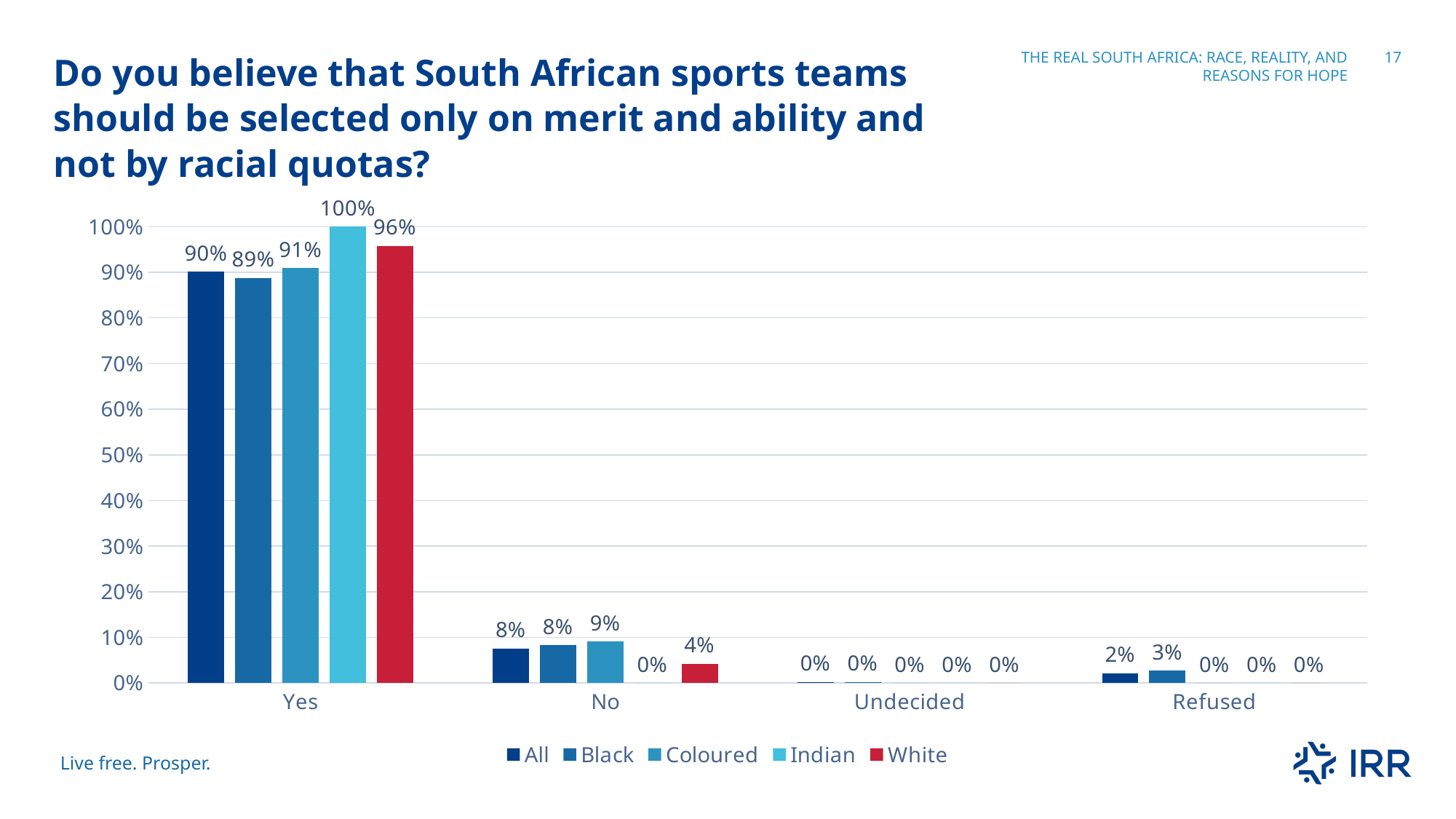
What is the difference between the White and All values for Yes? 6% What percentage of Indian respondents answered Yes? 100% Which group has the lowest value for Yes? Black Is the value for Black respondents answering Yes greater or less than 80%? greater How many response categories are shown on the x axis? 4 What kind of chart is shown on the slide? Bar chart Which group has the highest value for Yes? Indian Which series is shown in red? White Which is larger for No: the Coloured value or the White value? Coloured What percentage of Black respondents answered Refused? 3% What percentage of White respondents answered No? 4% How many series does the legend list? 5